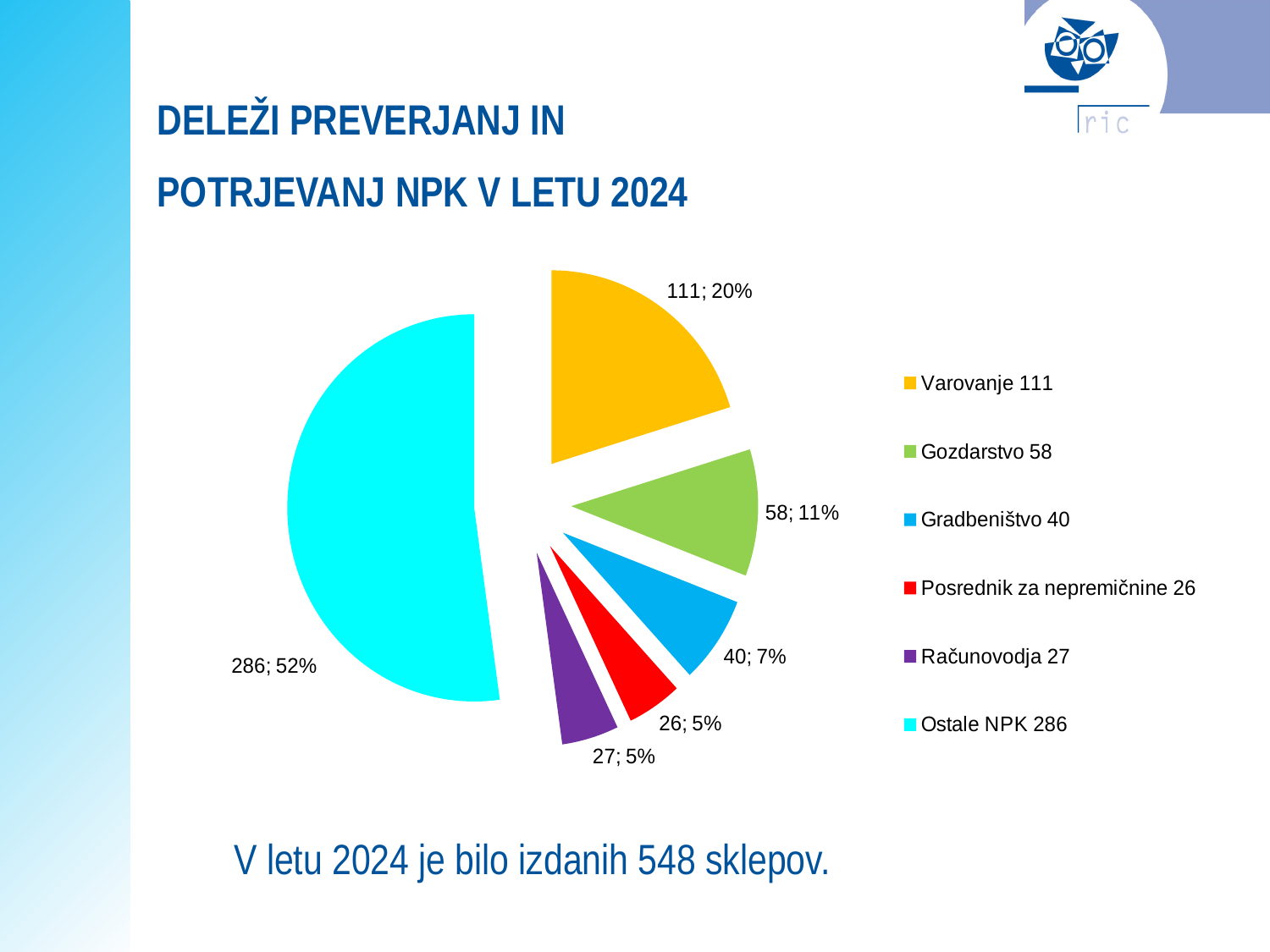
What colour is the Ostale NPK slice? cyan What kind of chart is shown on the slide? pie chart What is the value for Računovodja? 27 What is the difference between the values for Varovanje and Gozdarstvo? 53 How many slices does the pie chart have? 6 What is the value for Varovanje? 111 Which is larger, Gradbeništvo or Računovodja? Gradbeništvo Which category has the largest slice? Ostale NPK What percentage share does Ostale NPK have? 52% What is the value for Gradbeništvo? 40 Which category has the smallest value? Posrednik za nepremičnine What percentage share does Gozdarstvo have? 11%